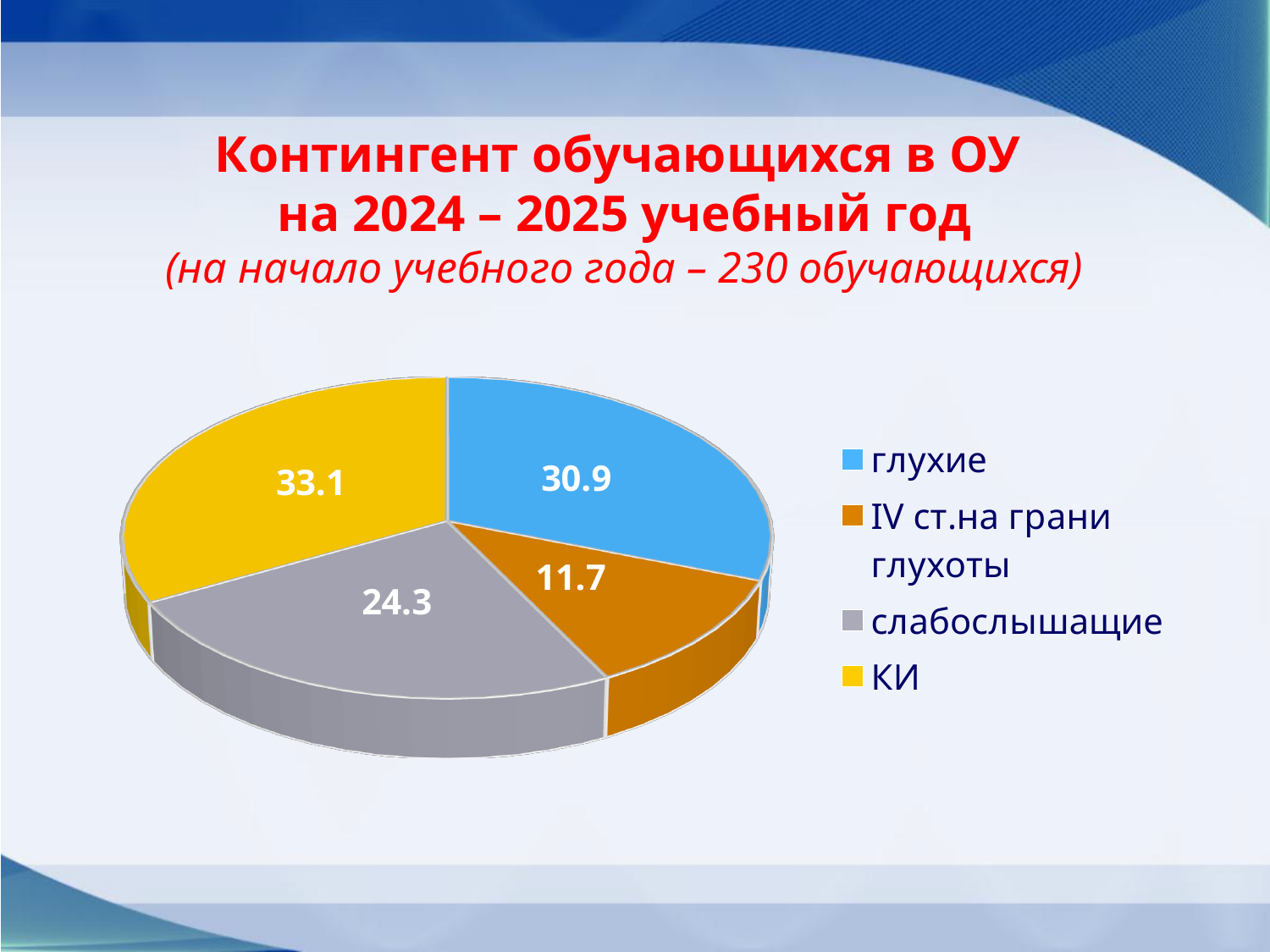
What type of chart is shown on the slide? pie chart What is the difference between the values for "КИ" and "глухие"? 2.2 How many categories does the pie chart show? 4 What colour is the "слабослышащие" slice in the pie chart? grey Which is larger, the slice for "глухие" or the slice for "слабослышащие"? глухие What value is shown for the "IV ст.на грани глухоты" slice? 11.7 What is the difference between the values for "слабослышащие" and "IV ст.на грани глухоты"? 12.6 Which category has the smallest slice of the pie? IV ст.на грани глухоты What value is shown for the "слабослышащие" slice? 24.3 What value is shown for the "глухие" slice of the pie chart? 30.9 Which category has the largest slice of the pie? КИ What value is shown for the "КИ" slice? 33.1